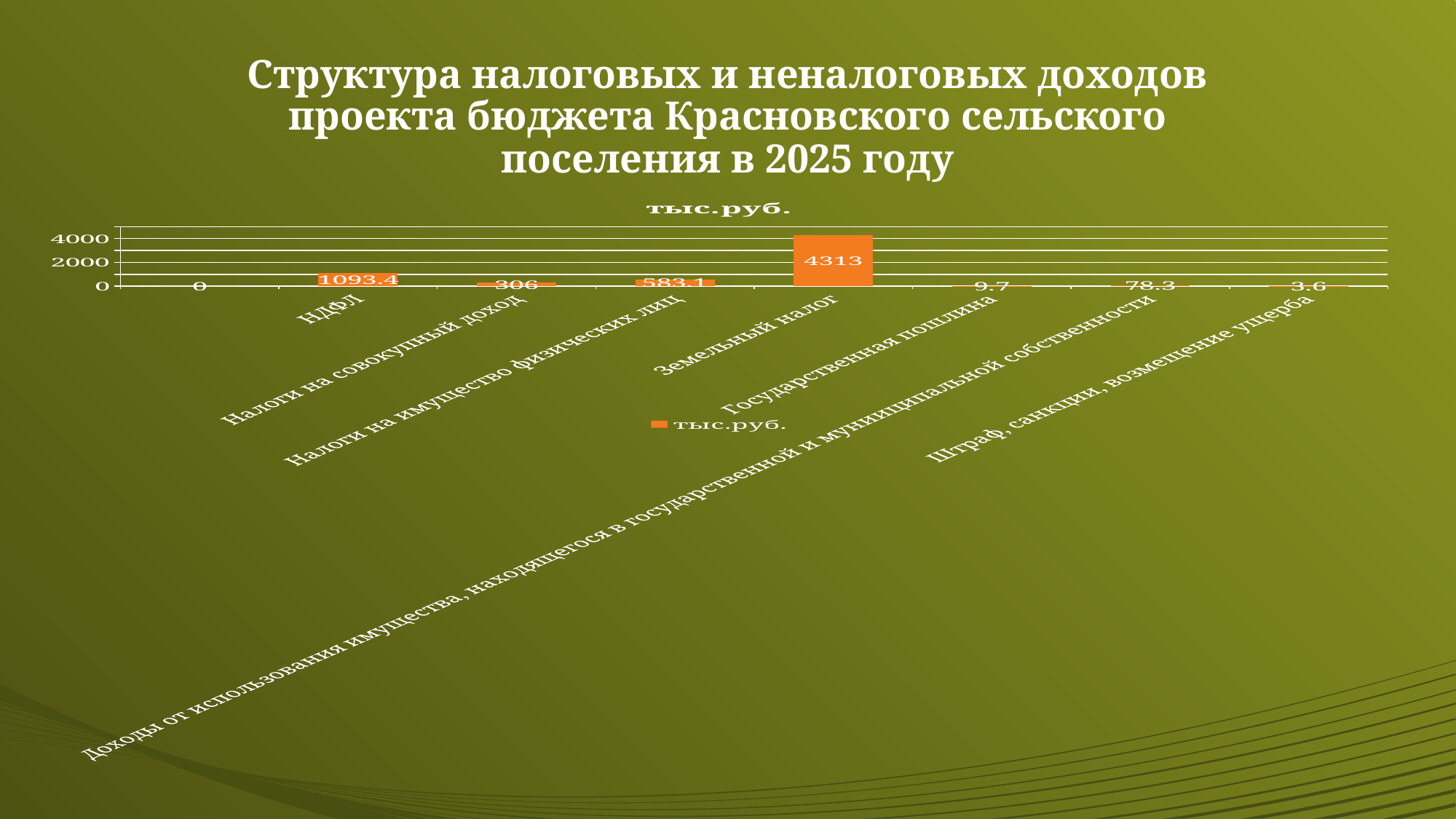
What is the value for НДФЛ? 1093.4 Which is larger: the value for Налоги на имущество физических лиц or for Налоги на совокупный доход? Налоги на имущество физических лиц What is the value for Штраф, санкции, возмещение ущерба? 3.6 What is the value for Земельный налог? 4313 What is the difference between the values for Земельный налог and НДФЛ? 3219.6 How many series does the legend list? 1 What is the value for Доходы от использования имущества, находящегося в государственной и муниципальной собственности? 78.3 What is the difference between the values for Налоги на имущество физических лиц and Налоги на совокупный доход? 277.1 What is the value for Государственная пошлина? 9.7 Which category has the highest value? Земельный налог Is the value for Земельный налог greater or less than 4000? greater Of the named categories, which has the lowest value? Штраф, санкции, возмещение ущерба